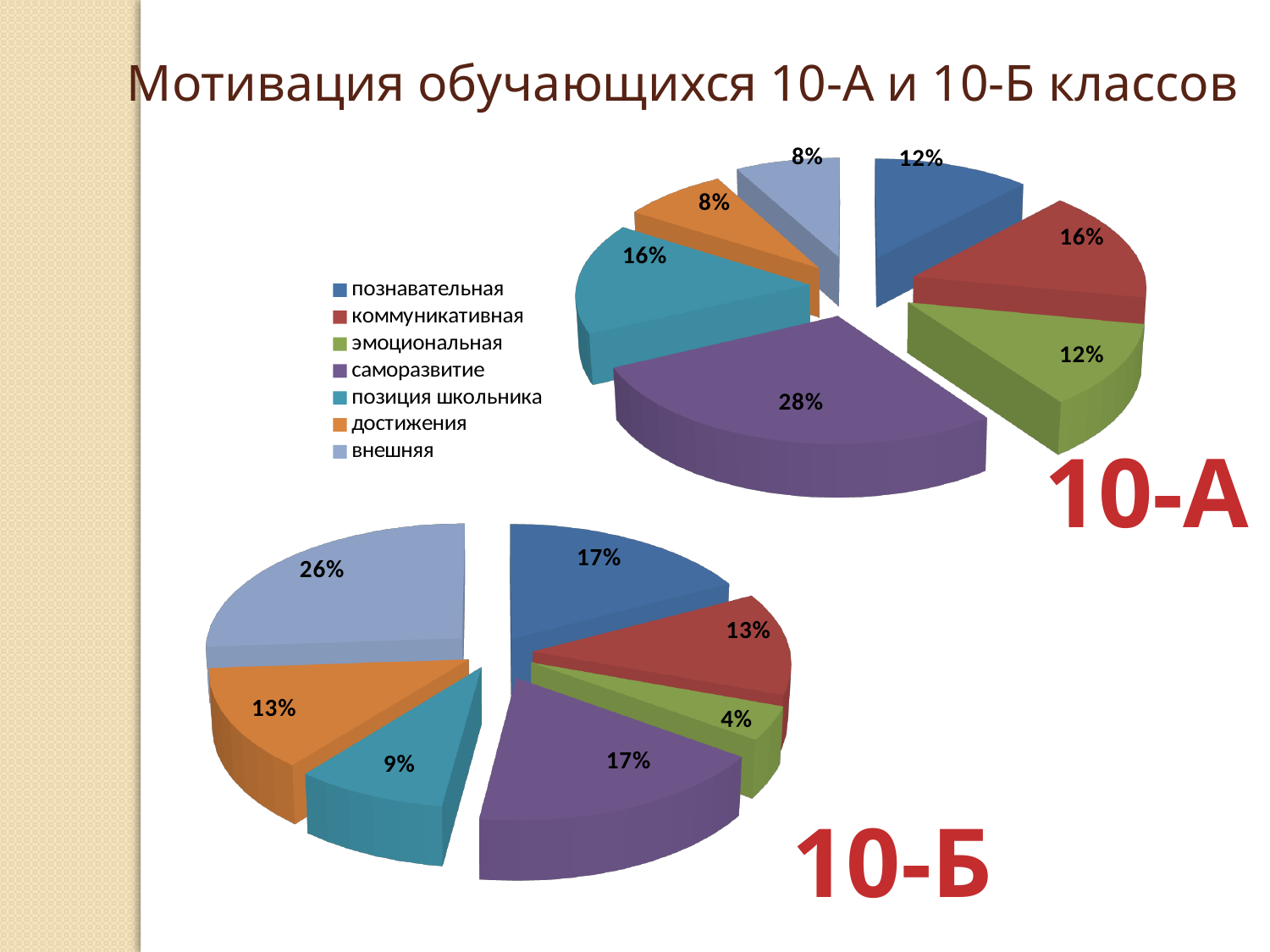
In the 10-Б pie chart, what is the share for эмоциональная? 4% What is the difference between the share for внешняя in the 10-Б chart and the share for внешняя in the 10-А chart? 18% In the 10-А pie chart, what is the share for саморазвитие? 28% How many categories does the legend list for the pie charts? 7 In the 10-А pie chart, what is the share for коммуникативная? 16% In the 10-Б pie chart, which category has the smallest share? эмоциональная In the 10-Б pie chart, which is larger: the share for познавательная or the share for позиция школьника? познавательная In the 10-А pie chart, which category has the largest share? саморазвитие What is the title of the slide? Мотивация обучающихся 10-А и 10-Б классов In the 10-Б pie chart, which category has the largest share? внешняя In the 10-Б pie chart, what is the share for внешняя? 26% What type of chart is used for the 10-А data? pie chart